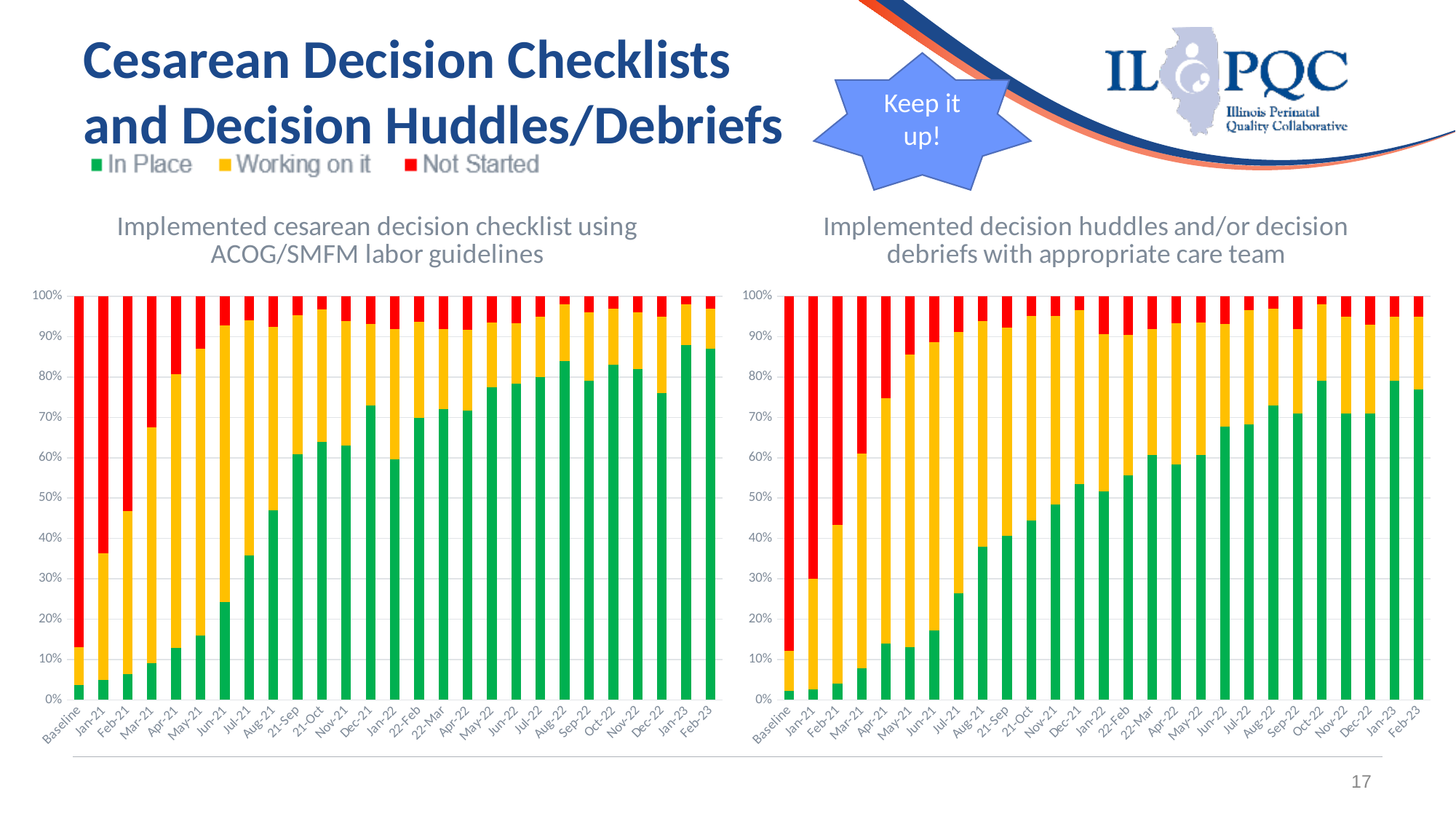
In the right chart, is the In Place value for Jan-21 greater or less than 10%? less What kind of chart is the left chart, 'Implemented cesarean decision checklist using ACOG/SMFM labor guidelines'? Stacked bar chart In the right chart, which is larger, the In Place share for Jul-21 or for Jul-22? Jul-22 In the left chart, is the In Place value for Jun-21 greater or less than 30%? less Which colour represents the 'In Place' series in the legend? Green How many series does the legend list for the charts on this slide? 3 In the right chart, is the In Place value for Feb-23 greater or less than 70%? greater In the right chart, 'Implemented decision huddles and/or decision debriefs with appropriate care team', does the In Place share generally rise or fall from Baseline to Feb-23? Rise In the left chart, which is larger, the In Place share for Baseline or for Feb-23? Feb-23 In the left chart, which period has the lowest In Place share? Baseline In the left chart, how many time-period categories are plotted along the x axis? 27